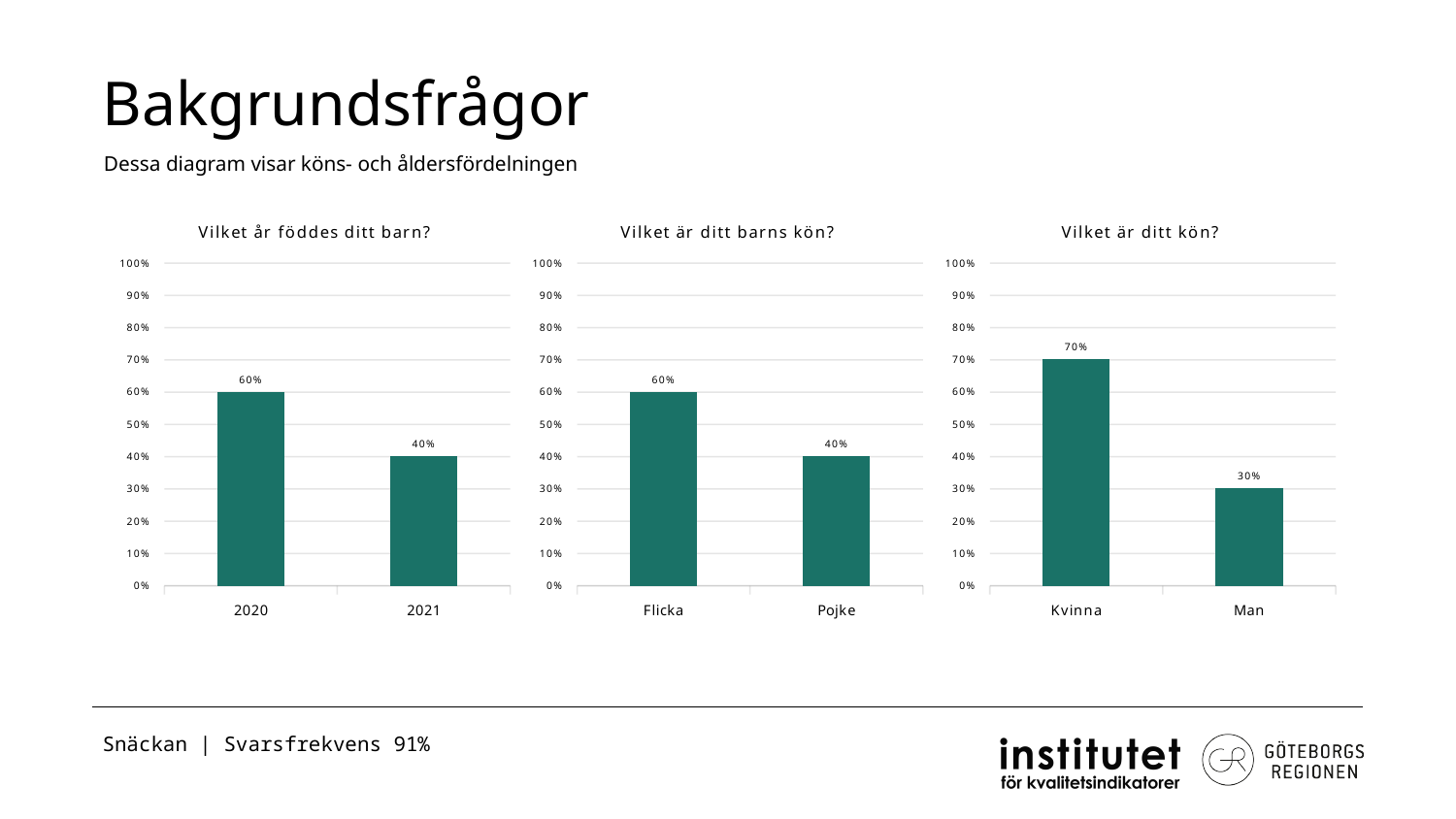
In the chart 'Vilket är ditt barns kön?', which is larger, the value for Flicka or the value for Pojke? Flicka In the chart 'Vilket år föddes ditt barn?', what is the value for 2021? 40% How many categories are shown in the chart 'Vilket år föddes ditt barn?'? 2 In the chart 'Vilket är ditt kön?', what is the difference between the values for Kvinna and Man? 40% In the chart 'Vilket är ditt barns kön?', what is the value for Pojke? 40% In the chart 'Vilket är ditt barns kön?', which category has the highest value? Flicka In the chart 'Vilket år föddes ditt barn?', what is the difference between the values for 2020 and 2021? 20% In the chart 'Vilket är ditt kön?', what is the value for Kvinna? 70% In the chart 'Vilket är ditt kön?', what is the value for Man? 30% What kind of chart is 'Vilket är ditt kön?'? Bar chart In the chart 'Vilket är ditt kön?', which category has the lowest value? Man In the chart 'Vilket år föddes ditt barn?', what is the value for 2020? 60%